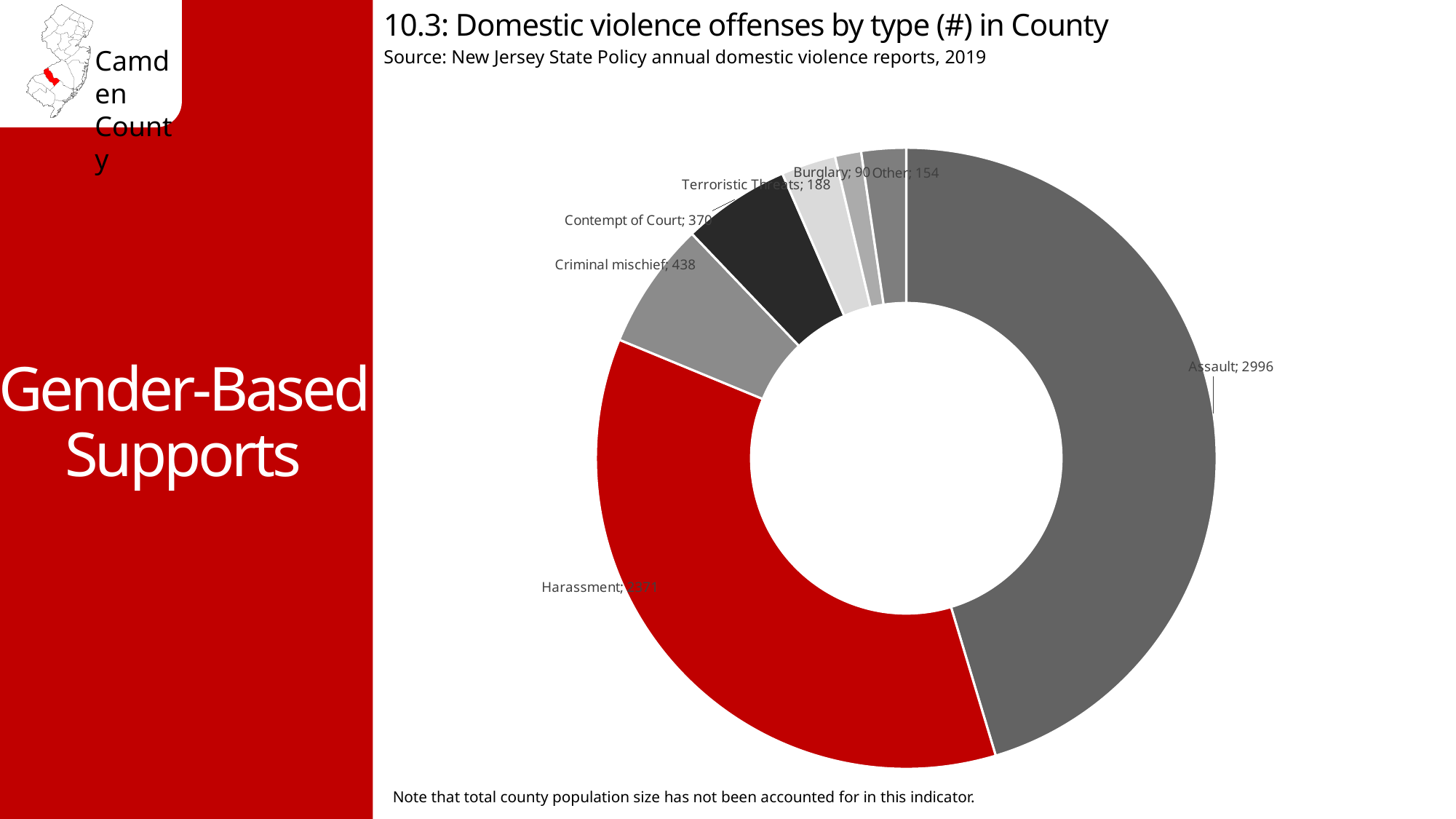
What is the value for Assault? 2996 What is the value for Terroristic Threats? 188 What is the value for Other? 154 Which offense type has the highest number? Assault Which offense type has the lowest number? Burglary What kind of chart is shown on the slide? doughnut chart What is the value for Criminal mischief? 438 What is the difference between Criminal mischief and Contempt of Court? 68 What is the value for Burglary? 90 Which is larger, Other or Burglary? Other How many offense types are shown in the chart? 7 What is the value for Contempt of Court? 370